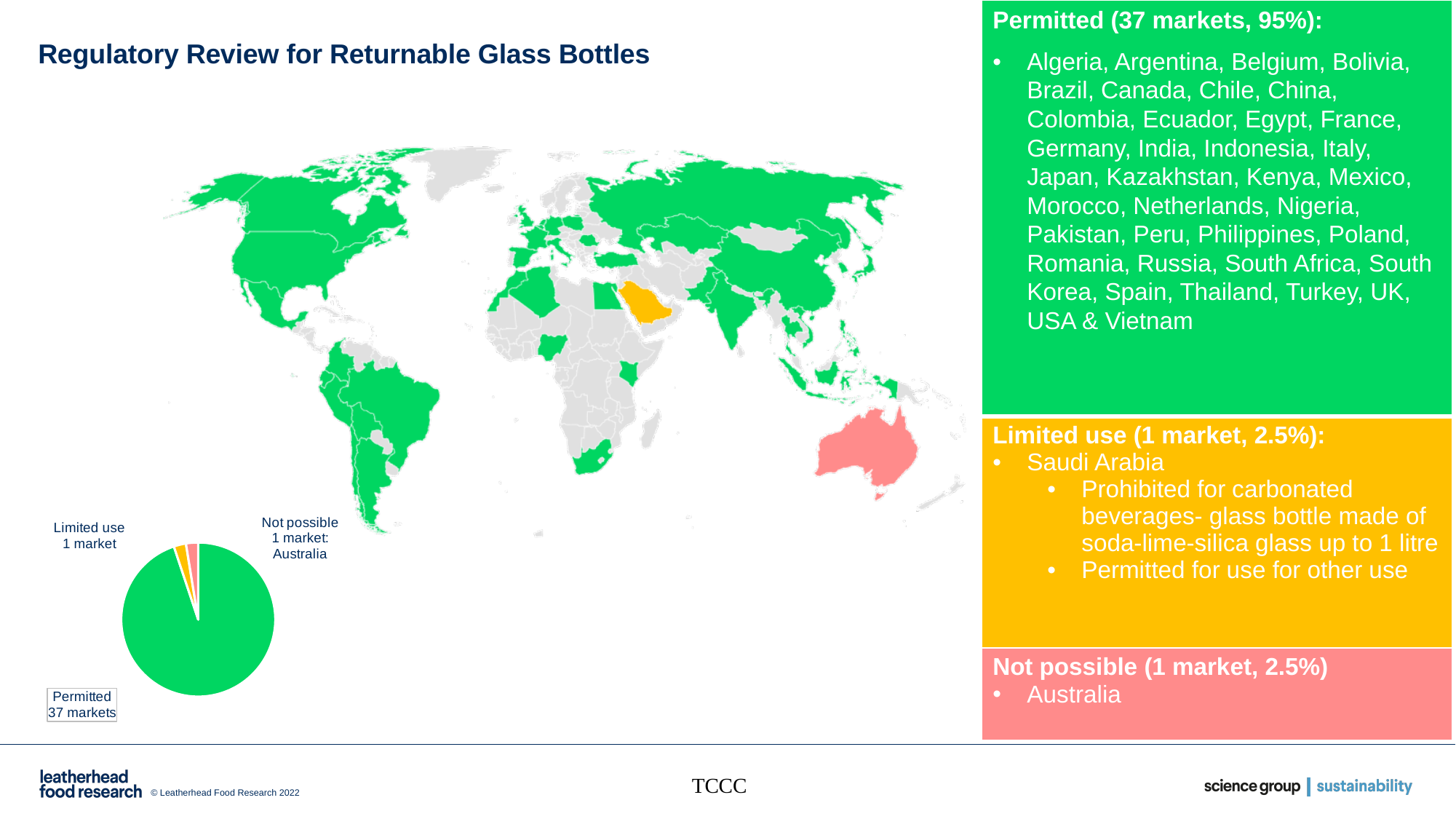
Which market is represented by the Not possible slice of the pie chart? Australia What is the difference in number of markets between the Permitted and Not possible slices? 36 markets Which category has the largest slice in the pie chart? Permitted How many slices does the pie chart have? 3 Which is larger in the pie chart, Permitted or Limited use? Permitted How many markets does the Limited use slice of the pie chart represent? 1 market What share of markets does the Permitted slice represent? 95% How many markets does the Permitted slice of the pie chart represent? 37 markets What kind of chart is shown at the bottom left of the slide? pie chart What is the total number of markets represented across all slices of the pie chart? 39 markets What colour is the Permitted slice in the pie chart? green What share of markets does the Not possible slice represent? 2.5%